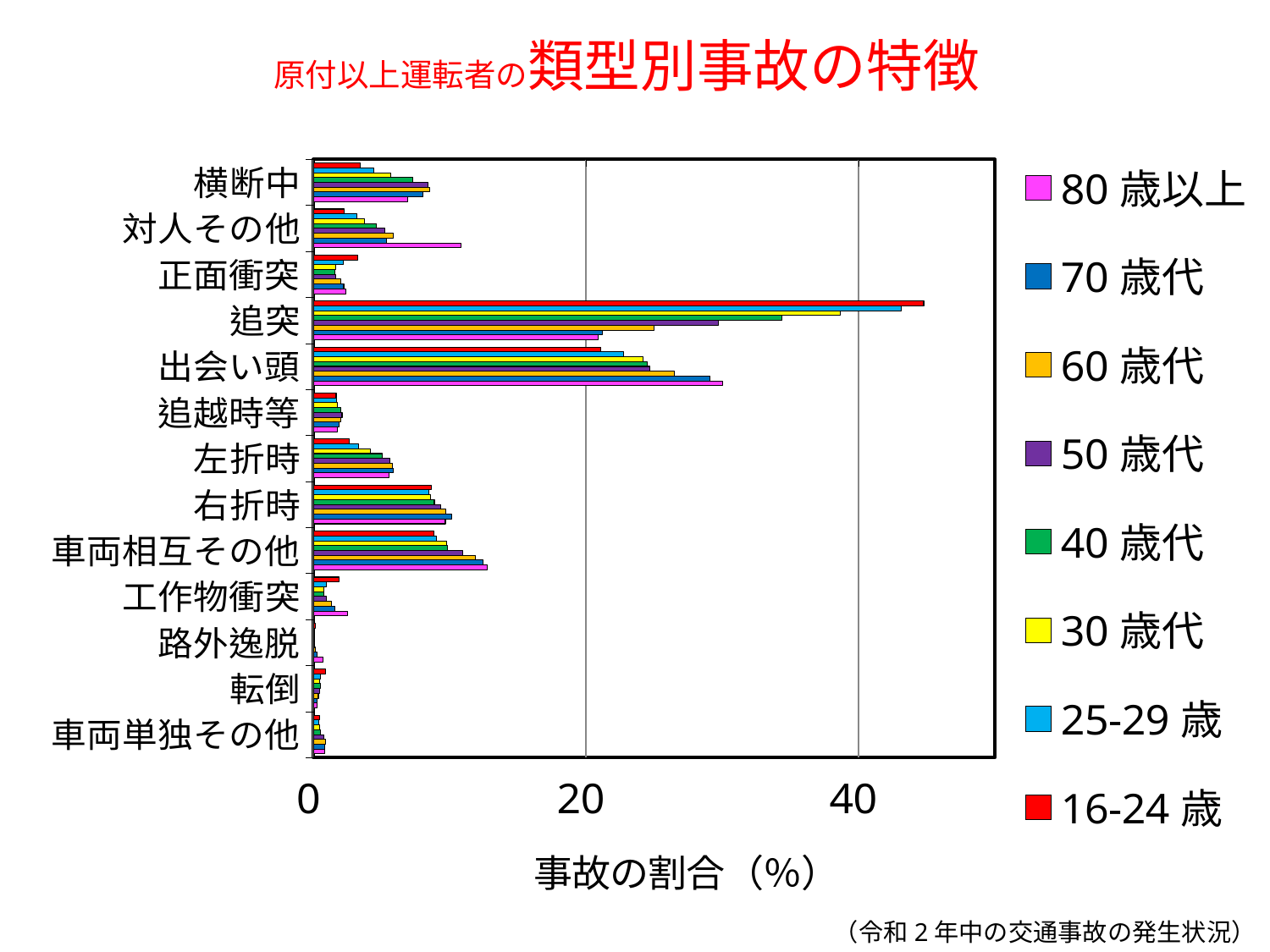
Is the value for 追突 in the 50 歳代 series greater or less than 40? less How many accident-type categories are listed on the vertical axis? 13 How many series (age groups) does the legend list? 8 What is the label of the horizontal axis? 事故の割合（%） For the 80 歳以上 series, which is larger: 追突 or 出会い頭? 出会い頭 Is the value for 追突 in the 80 歳以上 series greater or less than 40? less Which age group is shown in red in the legend? 16-24 歳 What kind of chart is shown on the slide? bar chart Is the value for 出会い頭 in the 80 歳以上 series greater or less than 20? greater For 対人その他, which series has the larger value: 80 歳以上 or 16-24 歳? 80 歳以上 Which accident type has the longest bar on the chart? 追突